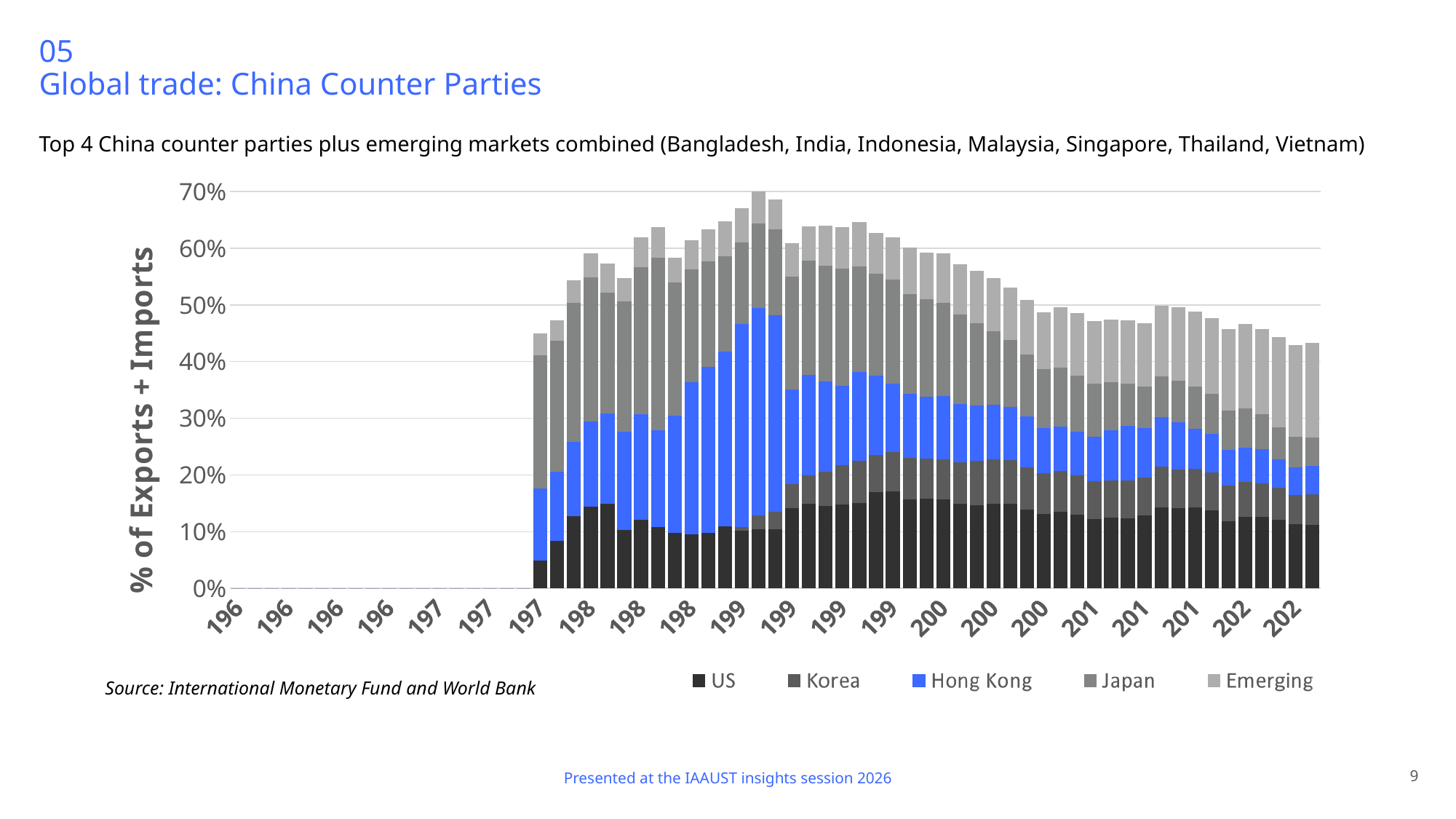
What is the title of the vertical axis? % of Exports + Imports Which series is shown in blue in the stacked bars? Hong Kong How many series does the legend list? 5 Is the total of the rightmost stacked bar greater or less than 50%? less What kind of chart is shown on the slide? stacked bar chart Is the total of the tallest stacked bar greater or less than 60%? greater Which series forms the bottom segment of each stacked bar? US Is the total of the first non-zero stacked bar on the left greater or less than 50%? less From the tallest bar onward to the right end of the chart, do the stacked totals generally rise or fall? fall